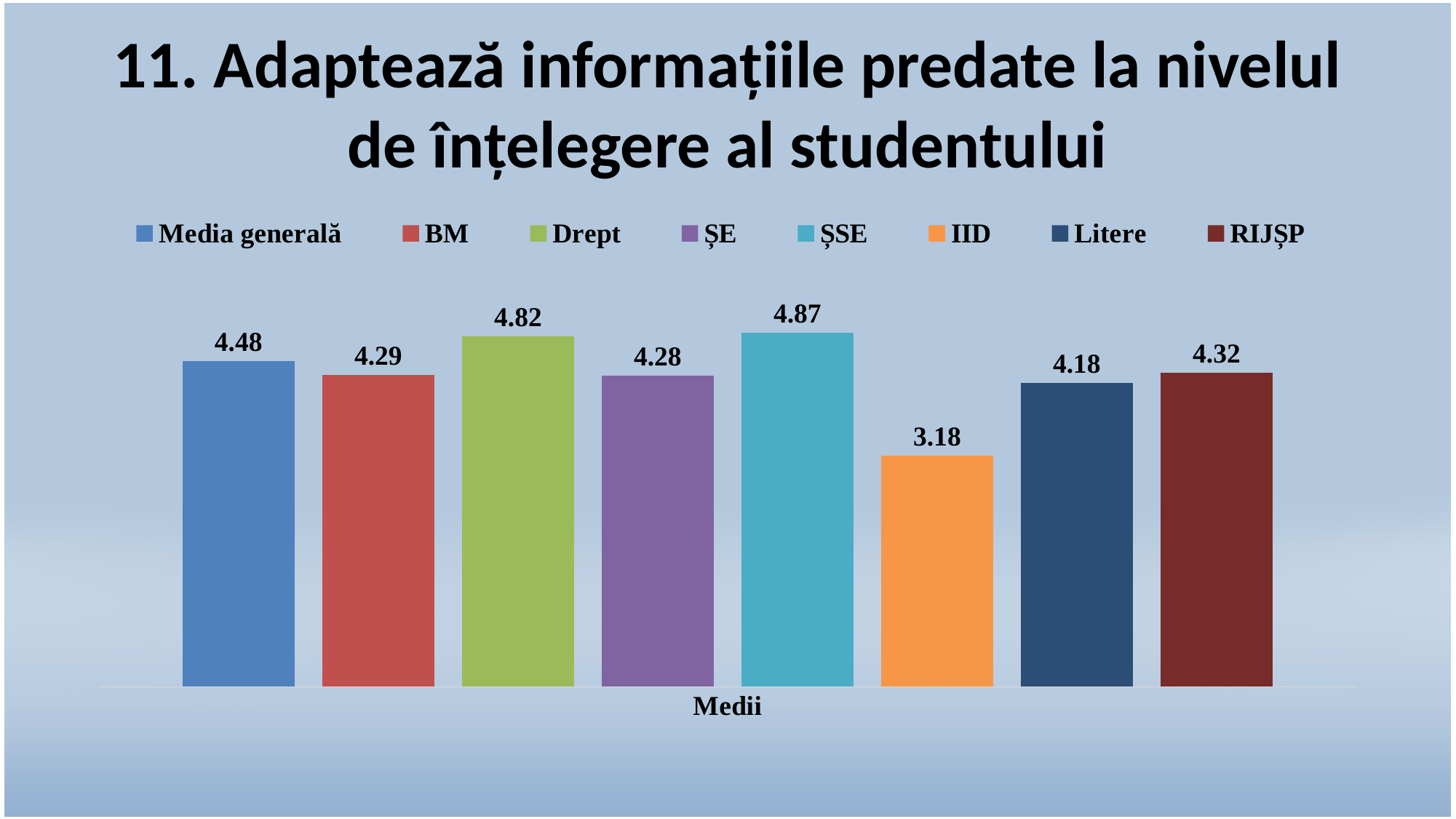
Which series has the highest value? ȘSE What is the value for Media generală? 4.48 How many series does the legend list? 8 What is the difference between the values for ȘSE and IID? 1.69 Which series has the lowest value? IID What is the value for IID? 3.18 What kind of chart is shown on the slide? Bar chart What is the value for Drept? 4.82 What is the difference between the values for Drept and Media generală? 0.34 Which is larger, the value for RIJȘP or the value for BM? RIJȘP What is the label shown on the x axis? Medii What is the value for Litere? 4.18